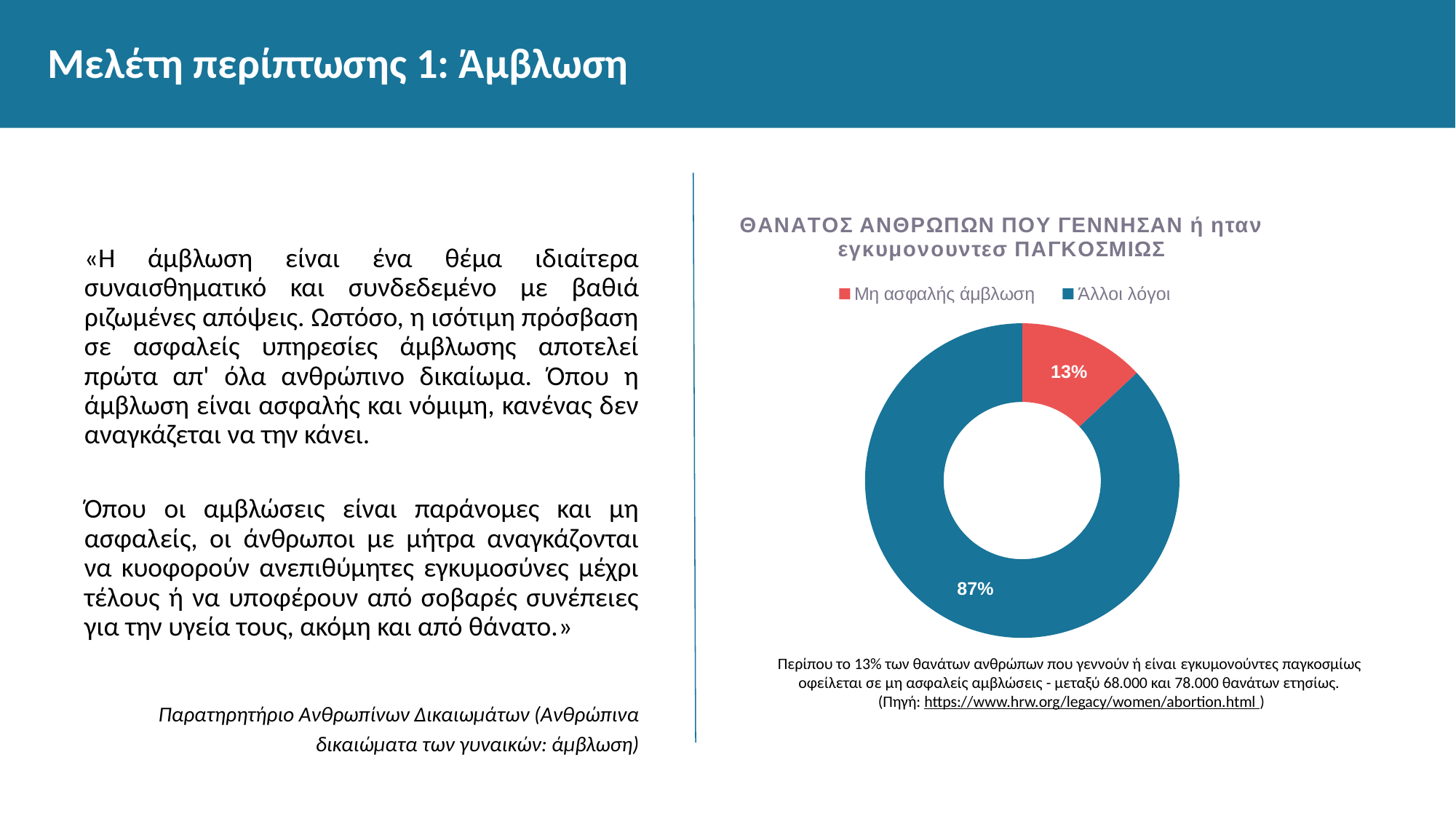
How many categories does the chart show? 2 What share of the chart does "Άλλοι λόγοι" represent? 87% What share of the chart does "Μη ασφαλής άμβλωση" represent? 13% What is the total of the two percentages shown on the chart? 100% What colour is the slice for "Μη ασφαλής άμβλωση"? Red Which category has the largest share of the chart? Άλλοι λόγοι What is the difference in percentage points between "Άλλοι λόγοι" and "Μη ασφαλής άμβλωση"? 74 How many entries does the chart legend list? 2 What kind of chart is shown on the slide? Doughnut chart What is the title of the chart? ΘΑΝΑΤΟΣ ΑΝΘΡΩΠΩΝ ΠΟΥ ΓΕΝΝΗΣΑΝ ή ηταν εγκυμονουντεσ ΠΑΓΚΟΣΜΙΩΣ Which category has the smallest share of the chart? Μη ασφαλής άμβλωση Which is larger: the share for "Μη ασφαλής άμβλωση" or the share for "Άλλοι λόγοι"? Άλλοι λόγοι